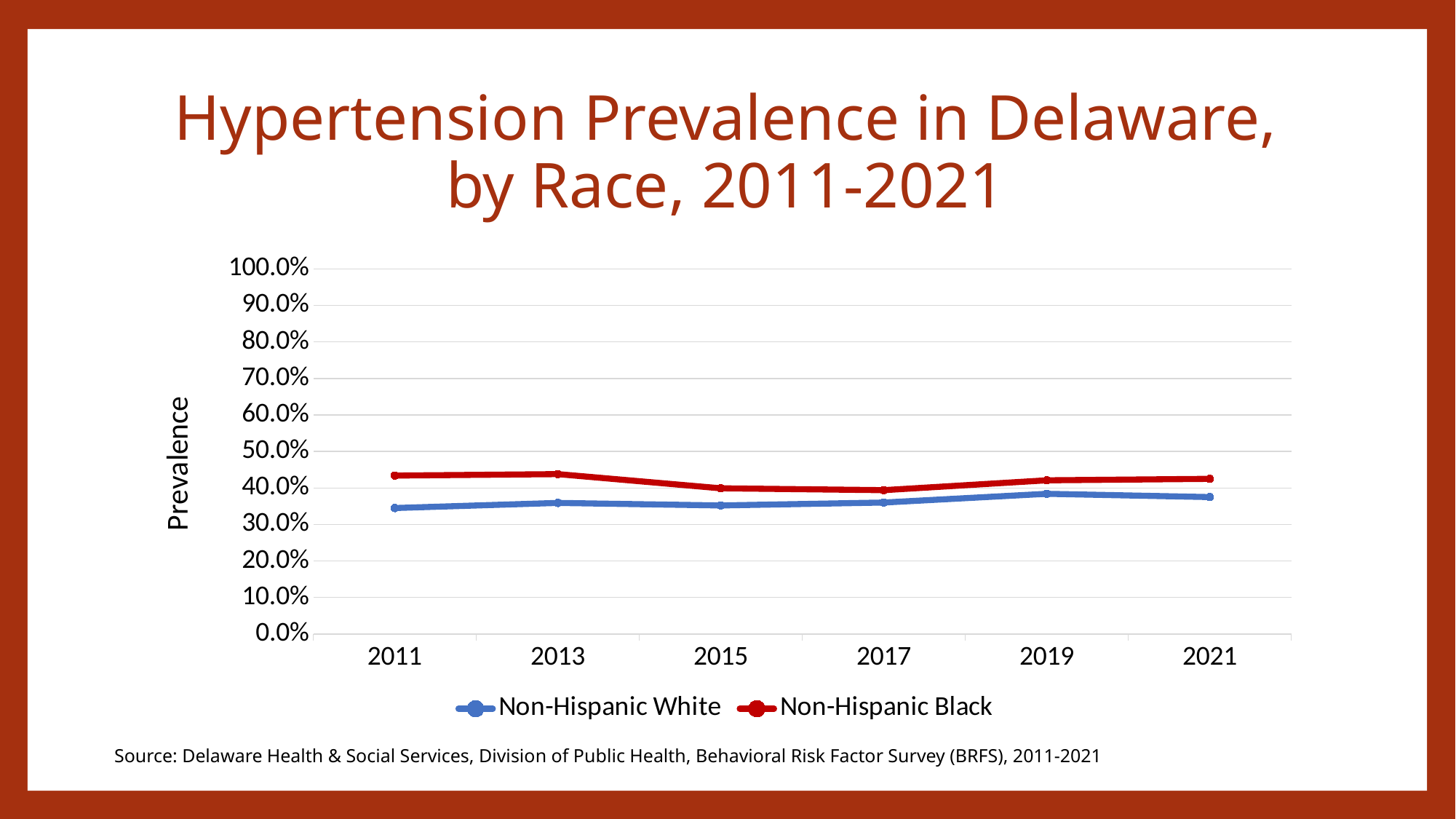
What is the title of the chart? Hypertension Prevalence in Delaware, by Race, 2011-2021 Which series has the higher prevalence in 2015, Non-Hispanic White or Non-Hispanic Black? Non-Hispanic Black Is the value for Non-Hispanic Black in 2013 greater or less than 50.0%? less Does the Non-Hispanic Black line rise or fall between 2013 and 2017? fall Does the Non-Hispanic White line rise or fall between 2017 and 2019? rise How many series does the legend list? 2 Is the value for Non-Hispanic White in 2019 greater or less than 40.0%? less How many years are plotted along the x axis? 6 Which colour is used for the Non-Hispanic Black series? red Is the value for Non-Hispanic Black in 2011 greater or less than 40.0%? greater What kind of chart is shown on the slide? line chart